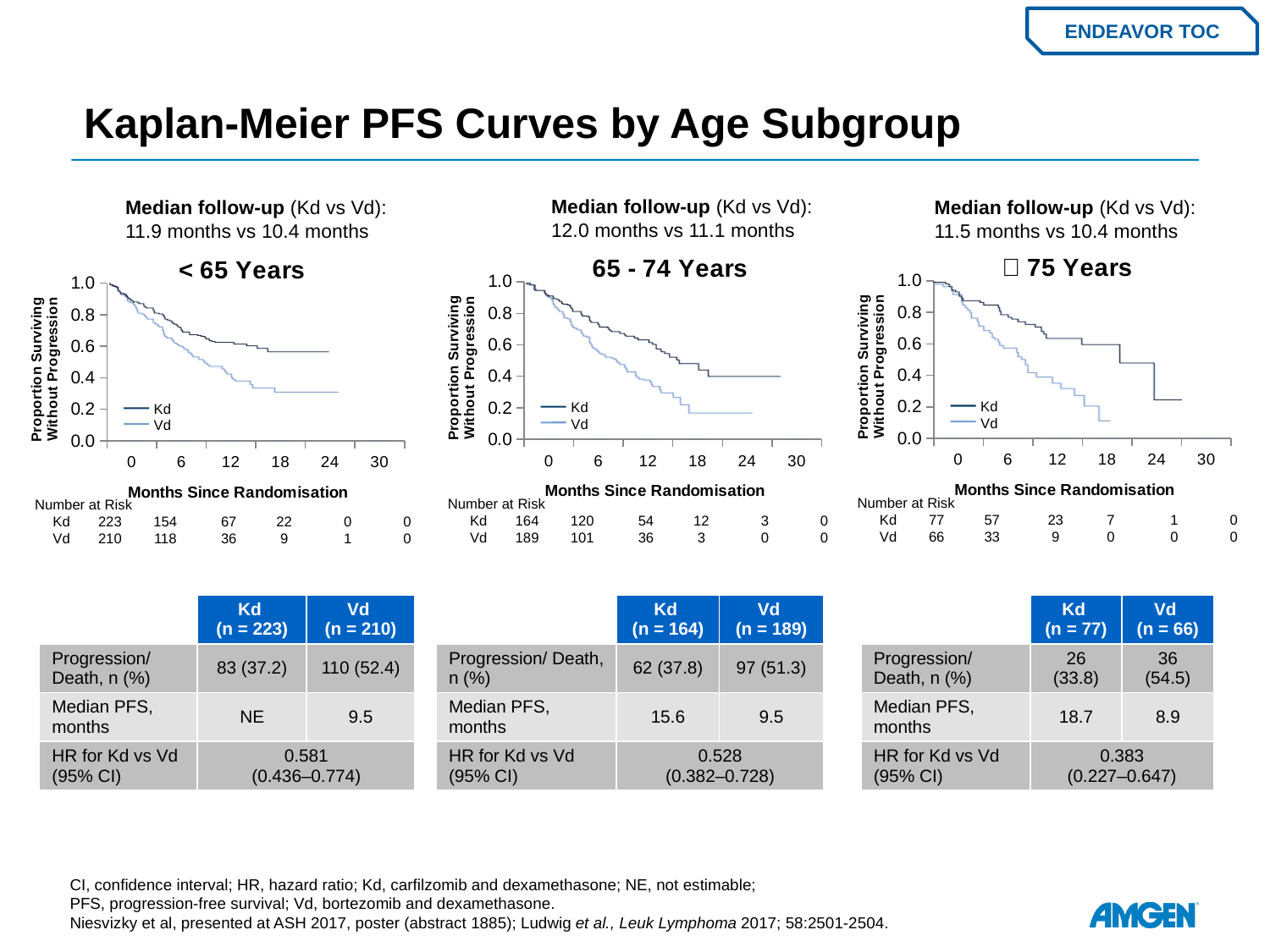
In the "65 - 74 Years" chart, what is the number at risk for Vd at 6 months? 101 In the "< 65 Years" chart, do the curves rise or fall as months since randomisation increase? fall In the "65 - 74 Years" chart, which series has the larger number at risk at 0 months, Kd or Vd? Vd How many series does the legend of the "65 - 74 Years" chart list? 2 In the "< 65 Years" chart, what is the difference between the Kd and Vd numbers at risk at 6 months? 36 What kind of chart is the "< 65 Years" chart? Line chart (Kaplan-Meier curve) What is the x-axis title of the "65 - 74 Years" chart? Months Since Randomisation In the "< 65 Years" chart, is the Kd curve at 24 months greater or less than 0.4? greater In the "75 Years" (oldest age group) chart, what is the number at risk for Kd at 12 months? 23 In the "65 - 74 Years" chart, is the Vd curve at 24 months greater or less than 0.4? less In the "< 65 Years" chart, what is the number at risk for Kd at 6 months? 154 In the "< 65 Years" chart, what is the number at risk for Vd at 12 months? 36